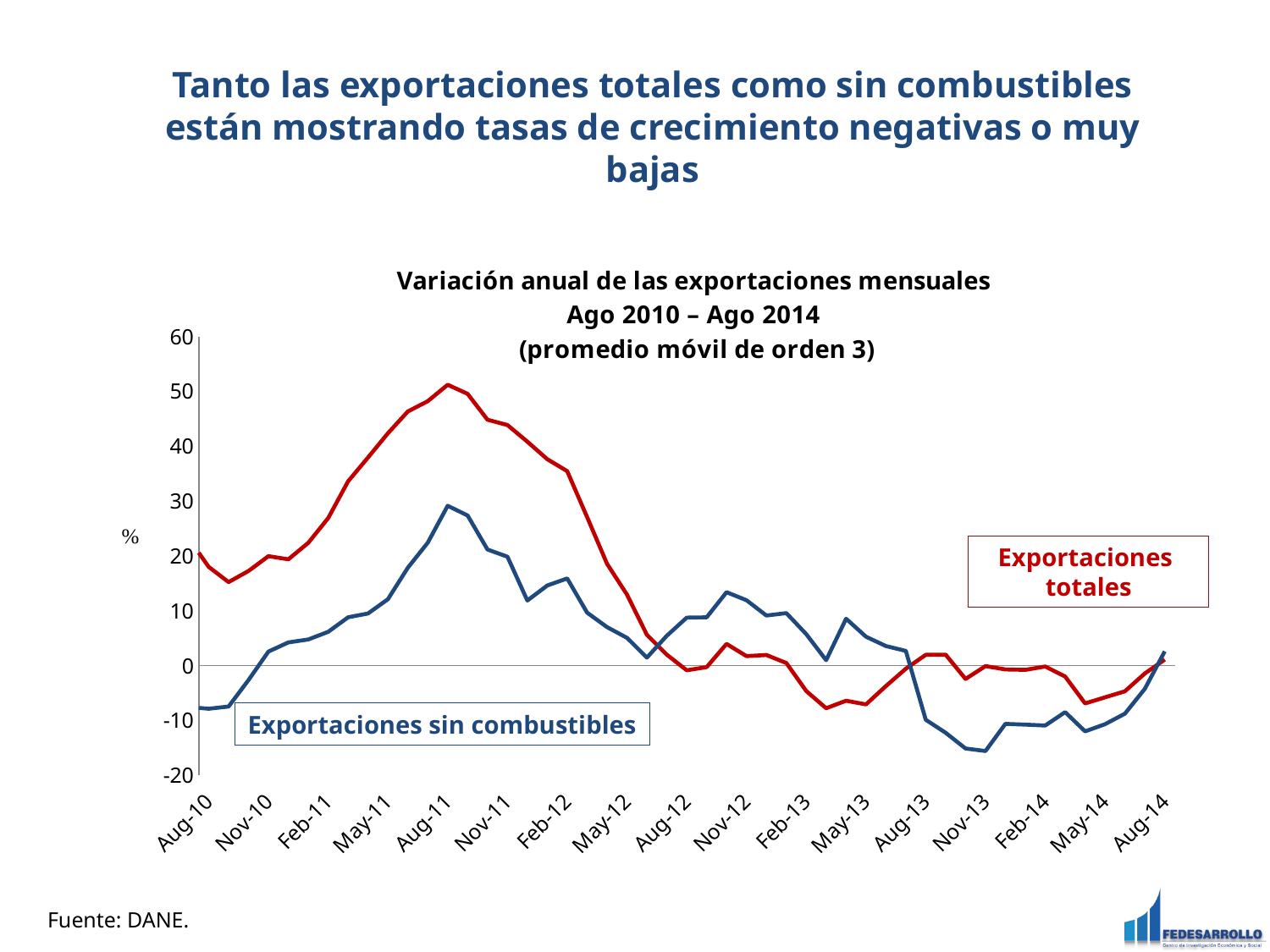
Does the Exportaciones totales line rise or fall between Aug-11 and May-12? fall At Nov-12, which series has the higher value, Exportaciones totales or Exportaciones sin combustibles? Exportaciones sin combustibles Which series reaches the highest peak on the chart? Exportaciones totales What is the title of the chart? Variación anual de las exportaciones mensuales Ago 2010 – Ago 2014 (promedio móvil de orden 3) Which colour is used for the Exportaciones totales line? red Is the value for Exportaciones sin combustibles at Aug-10 greater or less than 0? less Is the value for Exportaciones sin combustibles at Nov-13 greater or less than 0? less How many series are plotted on the chart? 2 What kind of chart is shown on the slide? line chart At Aug-11, which series has the higher value, Exportaciones totales or Exportaciones sin combustibles? Exportaciones totales Is the value for Exportaciones totales at Aug-10 greater or less than 10? greater